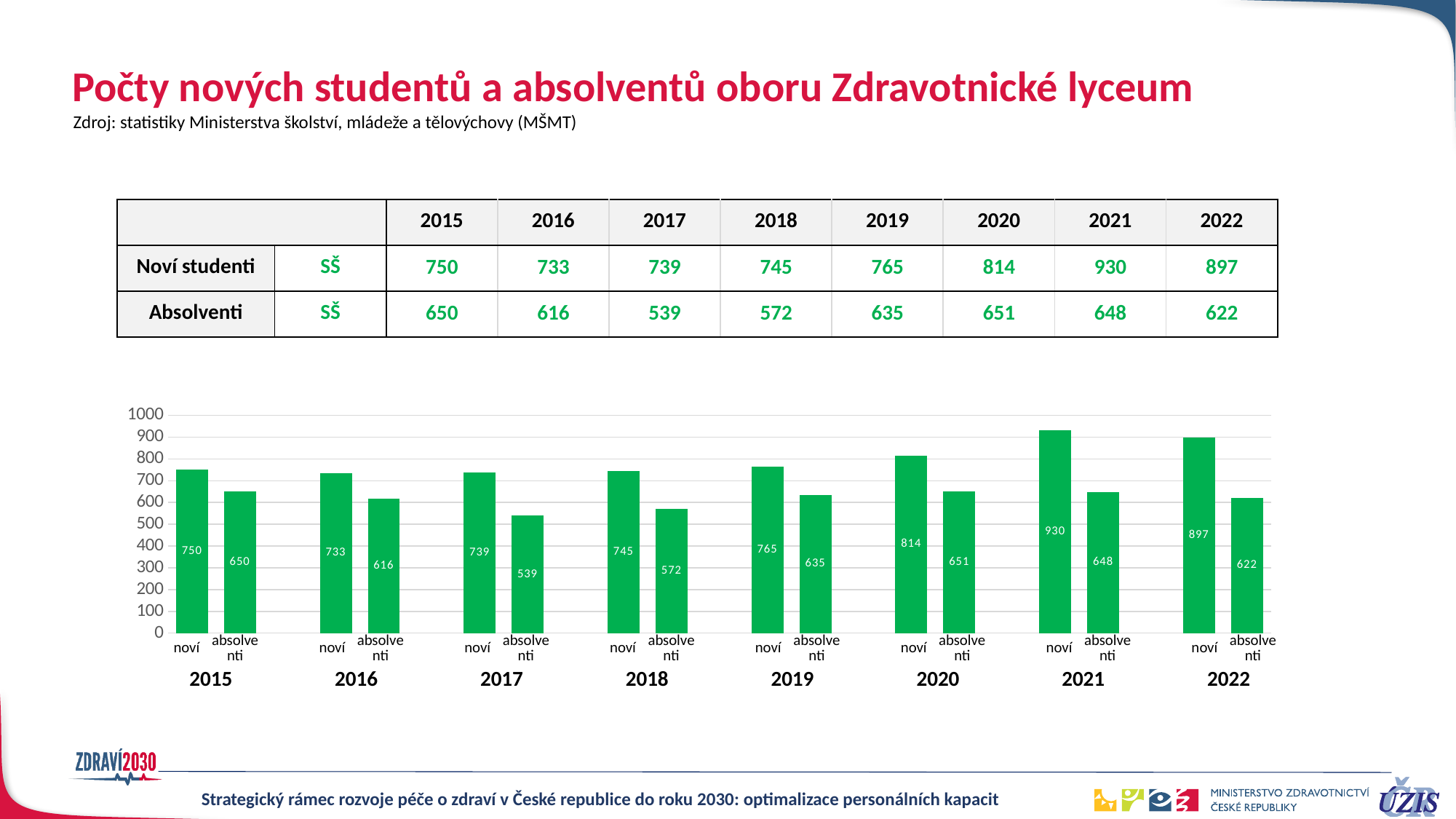
Which is larger, the 'absolventi' bar for 2015 or the 'absolventi' bar for 2016? 2015 Which year has the highest 'noví' bar? 2021 What is the value of the 'noví' bar for 2018? 745 What is the value of the 'noví' bar for 2021? 930 Do the 'noví' values rise or fall from 2018 to 2021? rise What is the difference between the 'noví' and 'absolventi' bars for 2022? 275 What is the value of the 'absolventi' bar for 2017? 539 Which year has the lowest 'absolventi' bar? 2017 What is the highest value shown on the y axis of the chart? 1000 What kind of chart is shown on the slide? bar chart How many years are shown on the x axis of the chart? 8 Is the value of the 'noví' bar for 2020 greater or less than 800? greater